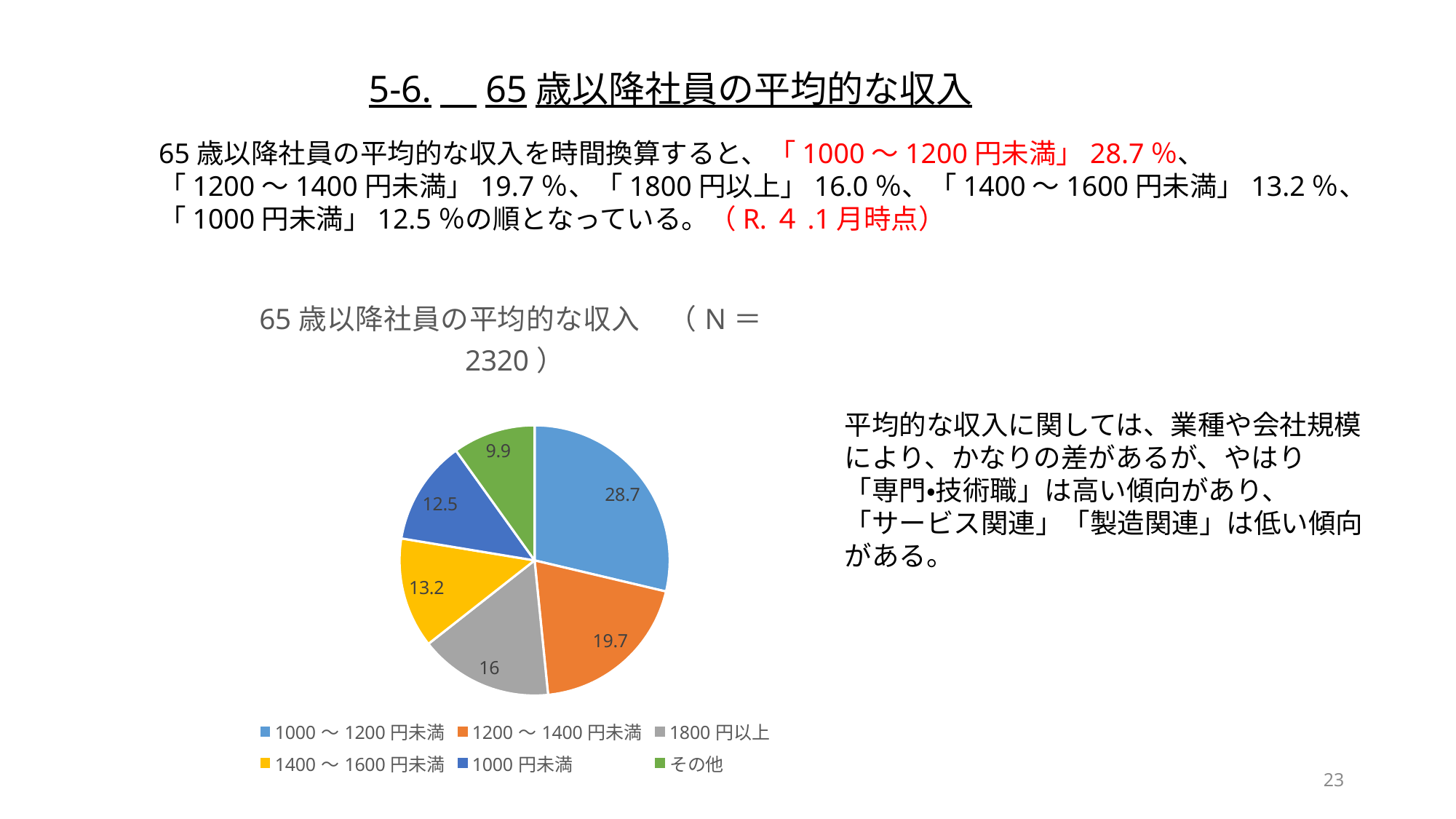
What type of chart is shown on the slide? pie chart What is the value shown for the 「1200～1400円未満」 slice? 19.7 Which category has the smallest slice of the pie? その他 What is the value shown for the 「1800円以上」 slice? 16 How many categories does the pie chart have? 6 What is the N value shown in the chart title? 2320 What is the value shown for the 「1000円未満」 slice? 12.5 Which is larger, the value for 「1400～1600円未満」 or the value for 「1000円未満」? 1400～1600円未満 Which category has the largest slice of the pie? 1000～1200円未満 What is the difference between the values for 「1000～1200円未満」 and 「1200～1400円未満」? 9 What is the value shown for the 「1000～1200円未満」 slice? 28.7 What is the value shown for the 「その他」 slice? 9.9